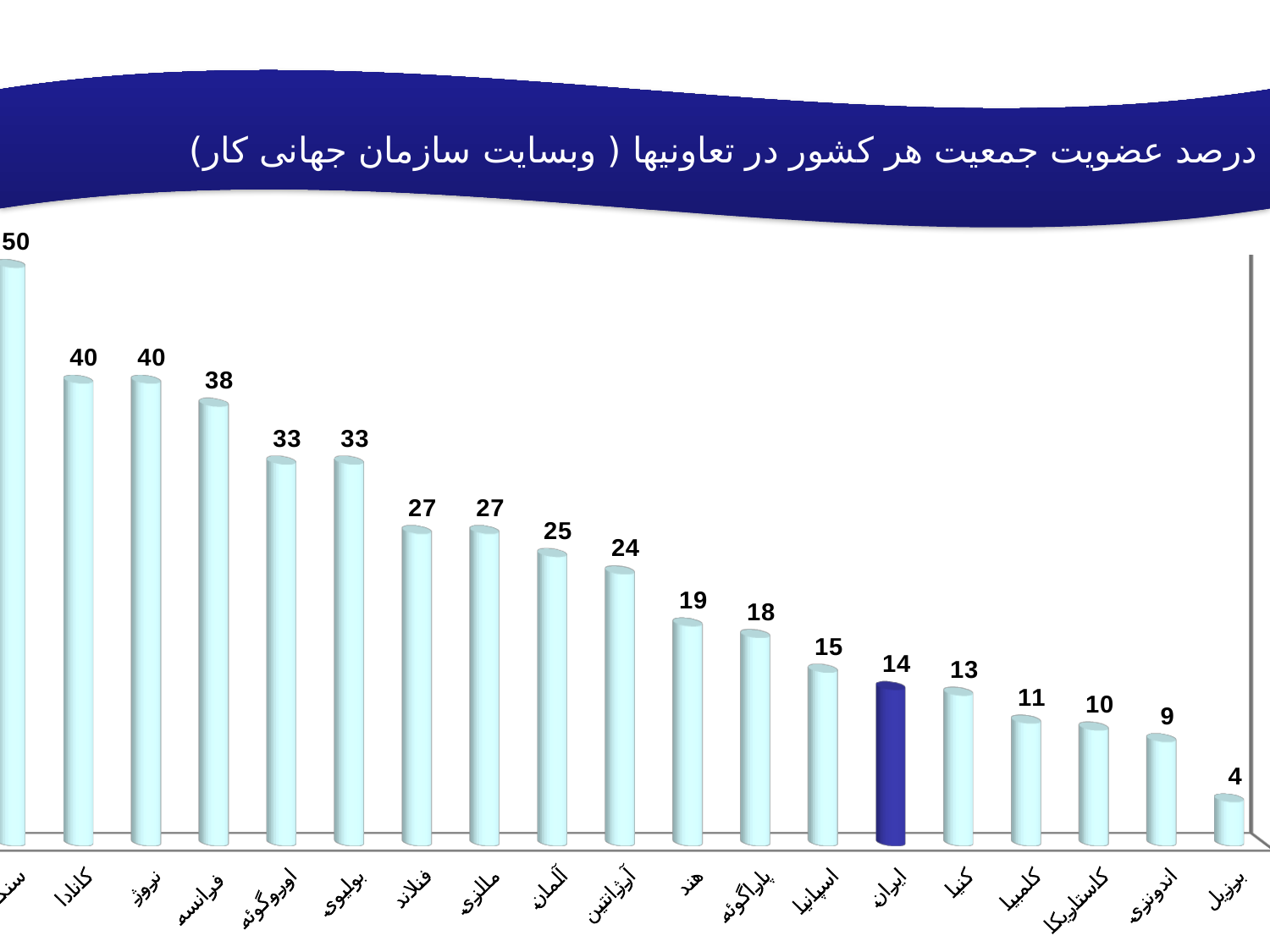
What is the difference between the values for هند (India) and کنیا (Kenya)? 6 How many bars are shown in the chart? 19 What is the difference between the values for فرانسه (France) and ایران (Iran)? 24 What is the value for آلمان (Germany)? 25 What is the value for کانادا (Canada)? 40 What is the value for برزیل (Brazil)? 4 Do the values rise or fall from left to right along the x axis? fall Which country has the lowest value? برزیل What is the value for ایران (Iran)? 14 Which bar is coloured dark blue, unlike the others? ایران Which is larger, the value for اسپانیا (Spain) or the value for پاراگوئه (Paraguay)? پاراگوئه What kind of chart is shown on the slide? bar chart